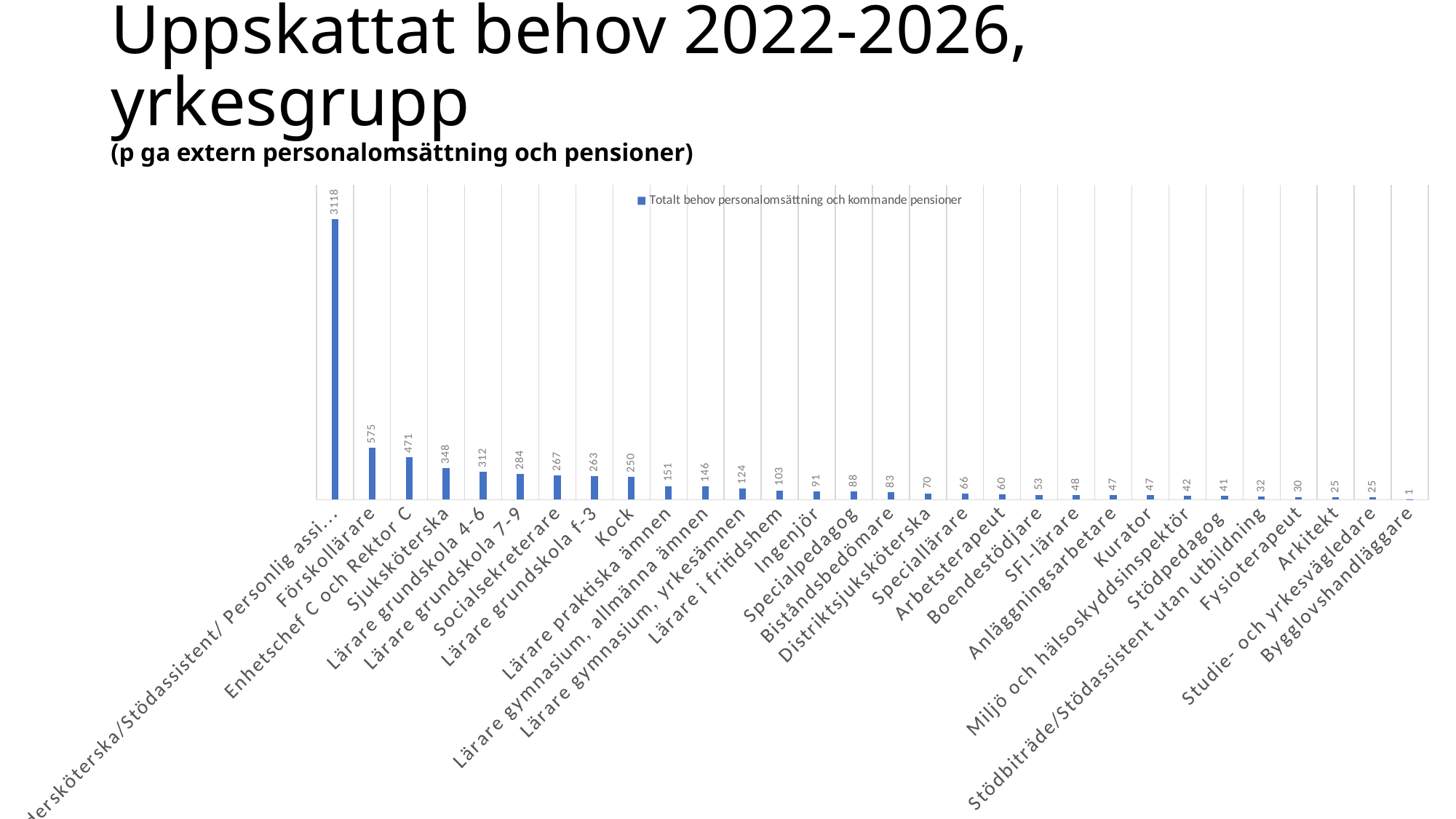
What is the value for Förskollärare? 575 What is the value for Sjuksköterska? 348 How many series does the legend list? 1 Which is larger, the value for Socialsekreterare or the value for Lärare grundskola f-3? Socialsekreterare What kind of chart is shown on the slide? Bar chart What is the value for Bygglovshandläggare? 1 How many categories are shown in the chart? 30 What is the legend entry of the series shown? Totalt behov personalomsättning och kommande pensioner What is the difference between the values for Förskollärare and Enhetschef C och Rektor C? 104 Which category has the lowest value? Bygglovshandläggare What is the highest value shown in the chart? 3118 What is the value for Kock? 250